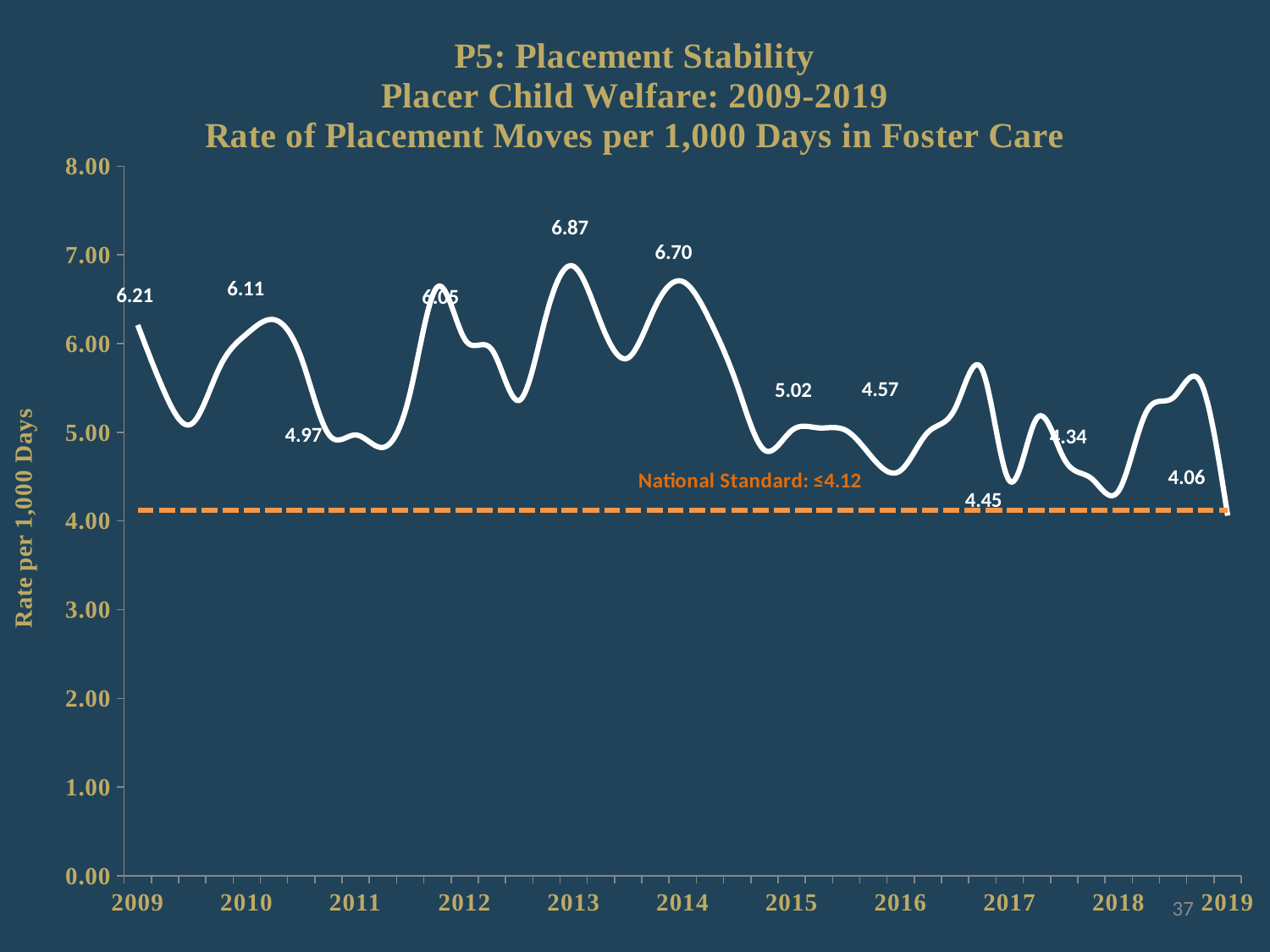
What is the difference between the labeled rates for 2013 and 2014? 0.17 What is the rate of placement moves per 1,000 days in foster care for 2016? 4.57 Which year has the highest labeled rate of placement moves? 2013 Which year has the lowest labeled rate of placement moves? 2019 What is the difference between the labeled rates for 2009 and 2019? 2.15 What is the rate of placement moves per 1,000 days in foster care for 2009? 6.21 What kind of chart is shown on the slide? line chart What is the National Standard shown by the dashed line on the chart? ≤4.12 What is the rate of placement moves per 1,000 days in foster care for 2019? 4.06 Is the value for 2019 greater or less than 5.00? less Which year has the larger labeled rate, 2015 or 2016? 2015 What is the rate of placement moves per 1,000 days in foster care for 2013? 6.87